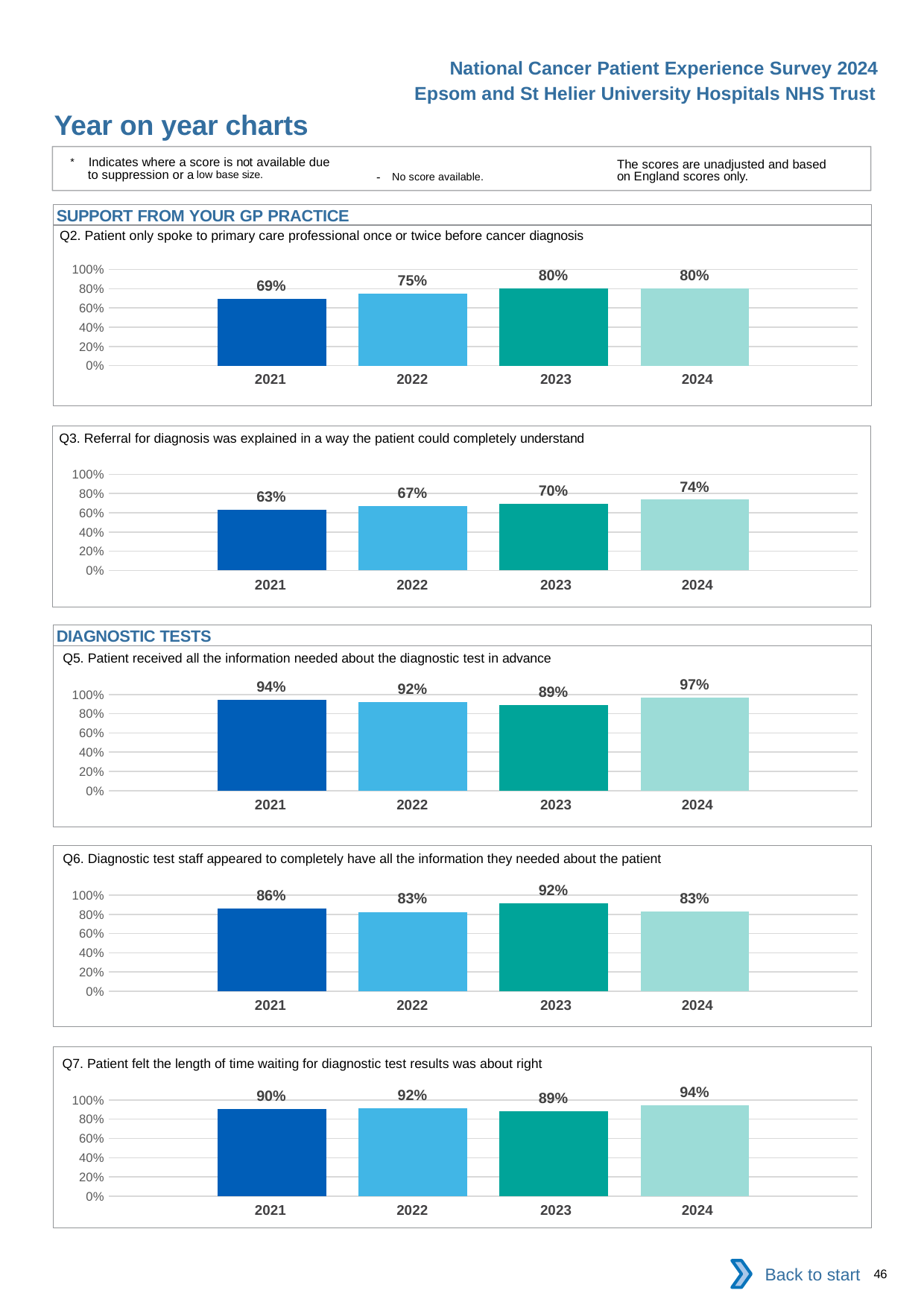
In the Q3 chart, which year has the highest value? 2024 In the Q3 chart, do the values rise or fall from 2021 to 2024? rise In the Q6 chart, what is the difference between the 2023 value and the 2024 value? 9% Which section heading appears above the Q5 chart? DIAGNOSTIC TESTS In the Q7 chart, which is larger, the value for 2022 or the value for 2023? 2022 In the Q3 chart, is the value for 2021 greater or less than 80%? less How many years are shown in the Q2 chart? 4 In the Q2 chart, what is the difference between the 2022 value and the 2021 value? 6% What kind of chart is the Q5 chart? bar chart In the Q7 chart, what is the value for 2024? 94% In the Q5 chart, which year has the lowest value? 2023 In the Q2 chart, what is the value for 2021? 69%